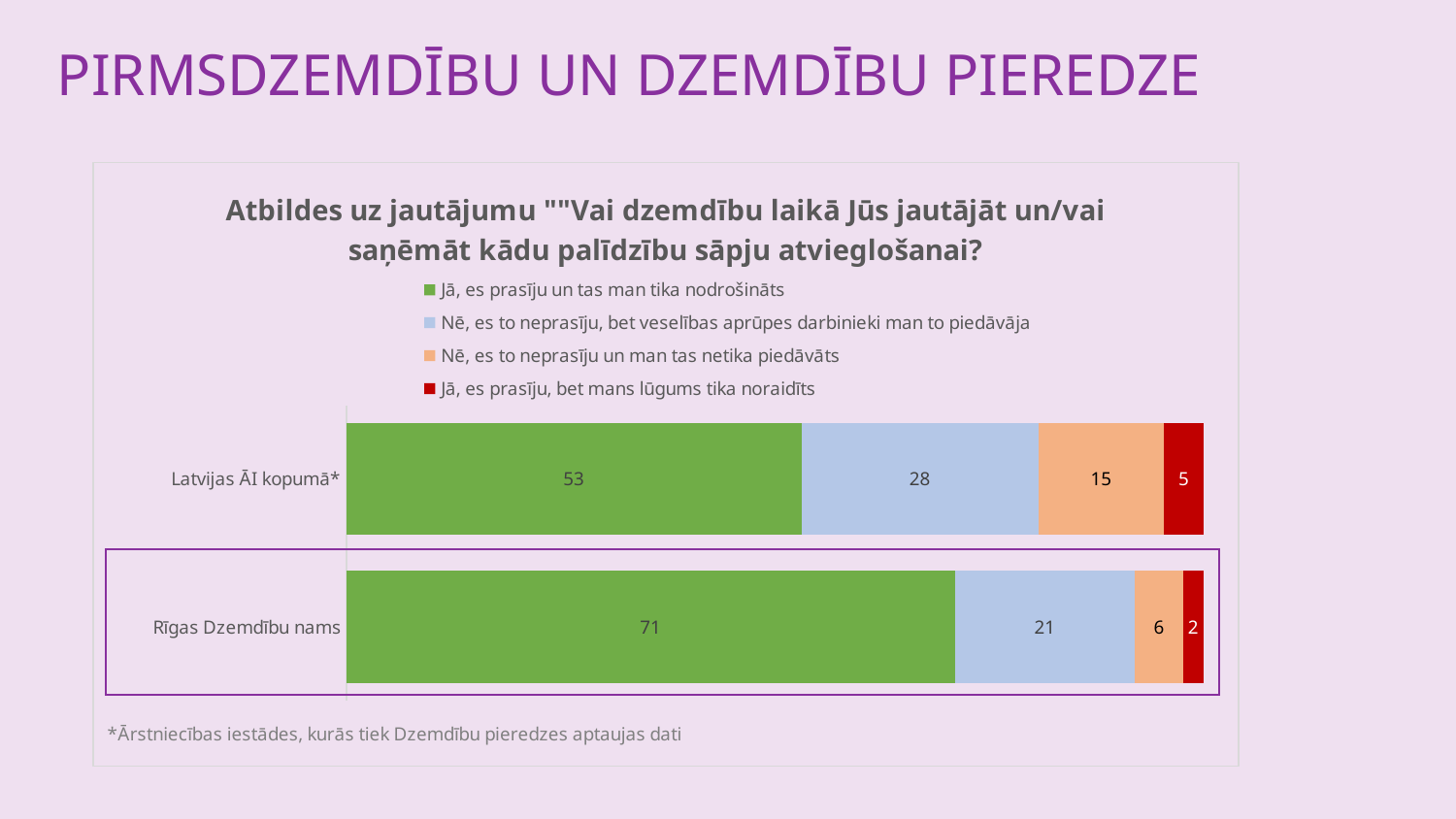
What kind of chart is this? Stacked bar chart What is the total of the stacked bar for Rīgas Dzemdību nams? 100 What value is shown for "Jā, es prasīju un tas man tika nodrošināts" for Latvijas ĀI kopumā*? 53 What is the total of the stacked bar for Latvijas ĀI kopumā*? 101 What value is shown for "Nē, es to neprasīju un man tas netika piedāvāts" for Rīgas Dzemdību nams? 6 What value is shown for "Jā, es prasīju, bet mans lūgums tika noraidīts" for Latvijas ĀI kopumā*? 5 What is the difference between the "Nē, es to neprasīju un man tas netika piedāvāts" values for Latvijas ĀI kopumā* and Rīgas Dzemdību nams? 9 Which category has the higher value for "Jā, es prasīju un tas man tika nodrošināts"? Rīgas Dzemdību nams What value is shown for "Nē, es to neprasīju, bet veselības aprūpes darbinieki man to piedāvāja" for Rīgas Dzemdību nams? 21 What is the difference between the "Jā, es prasīju un tas man tika nodrošināts" values for Rīgas Dzemdību nams and Latvijas ĀI kopumā*? 18 How many series does the legend list? 4 How many categories are shown on the chart? 2